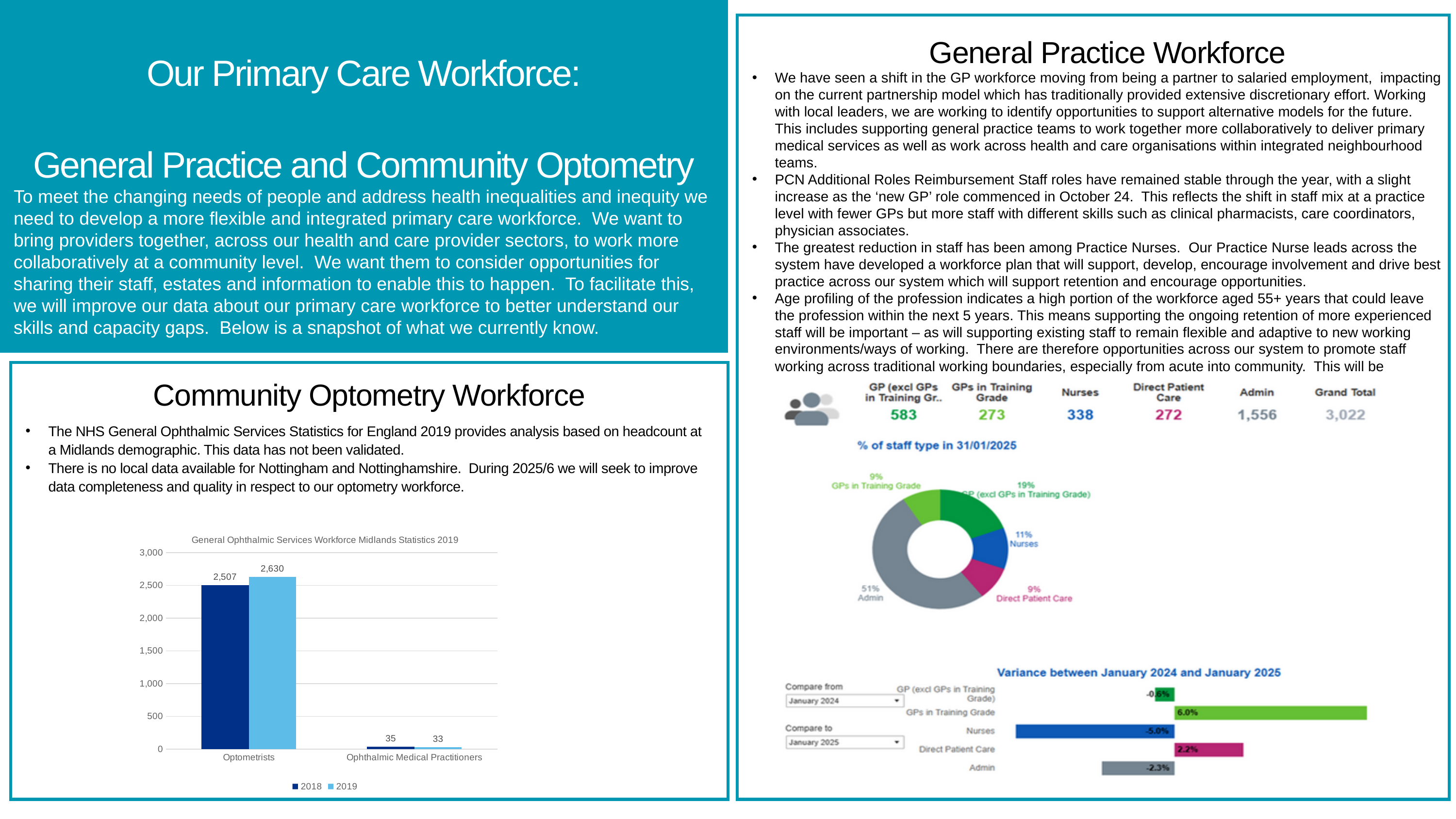
In the 'Variance between January 2024 and January 2025' bar chart, what is the value for Nurses? -5.0% In the '% of staff type in 31/01/2025' donut chart, what share is Nurses? 11% In the '% of staff type in 31/01/2025' donut chart, what share is Admin? 51% In the 'General Ophthalmic Services Workforce Midlands Statistics 2019' bar chart, what is the 2018 value for Ophthalmic Medical Practitioners? 35 In the 'General Ophthalmic Services Workforce Midlands Statistics 2019' bar chart, what is the 2019 value for Optometrists? 2,630 How many series does the legend of the 'General Ophthalmic Services Workforce Midlands Statistics 2019' bar chart list? 2 In the '% of staff type in 31/01/2025' donut chart, which staff type has the largest share? Admin How many categories are shown in the 'Variance between January 2024 and January 2025' bar chart? 5 In the 'General Ophthalmic Services Workforce Midlands Statistics 2019' bar chart, what is the difference between the 2019 and 2018 values for Optometrists? 123 In the 'General Ophthalmic Services Workforce Midlands Statistics 2019' bar chart, which is larger for Ophthalmic Medical Practitioners, the 2018 value or the 2019 value? 2018 What type of chart is the 'General Ophthalmic Services Workforce Midlands Statistics 2019' chart? Bar chart In the 'Variance between January 2024 and January 2025' bar chart, which category has the highest value? GPs in Training Grade